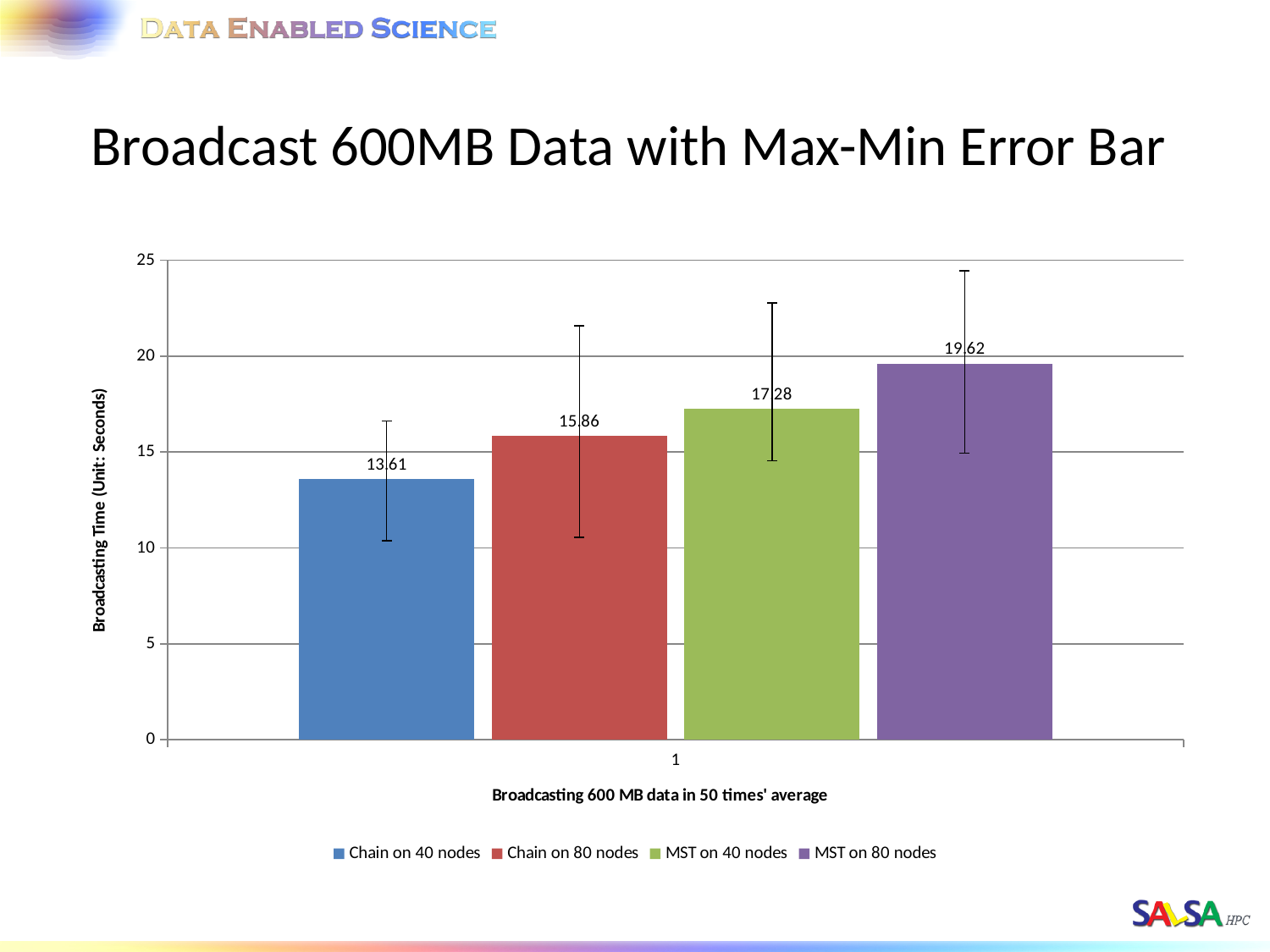
What is the difference in broadcasting time between MST on 80 nodes and Chain on 40 nodes? 6.01 What kind of chart is shown on the slide? Bar chart How many series does the legend list? 4 What is the label of the y axis? Broadcasting Time (Unit: Seconds) What is the broadcasting time for Chain on 40 nodes? 13.61 Which series has the highest broadcasting time? MST on 80 nodes What is the broadcasting time for Chain on 80 nodes? 15.86 What is the broadcasting time for MST on 80 nodes? 19.62 What is the difference in broadcasting time between MST on 40 nodes and Chain on 80 nodes? 1.42 Which series has the lowest broadcasting time? Chain on 40 nodes Is the value for MST on 40 nodes greater or less than 15? greater Which has a larger broadcasting time, Chain on 80 nodes or MST on 40 nodes? MST on 40 nodes